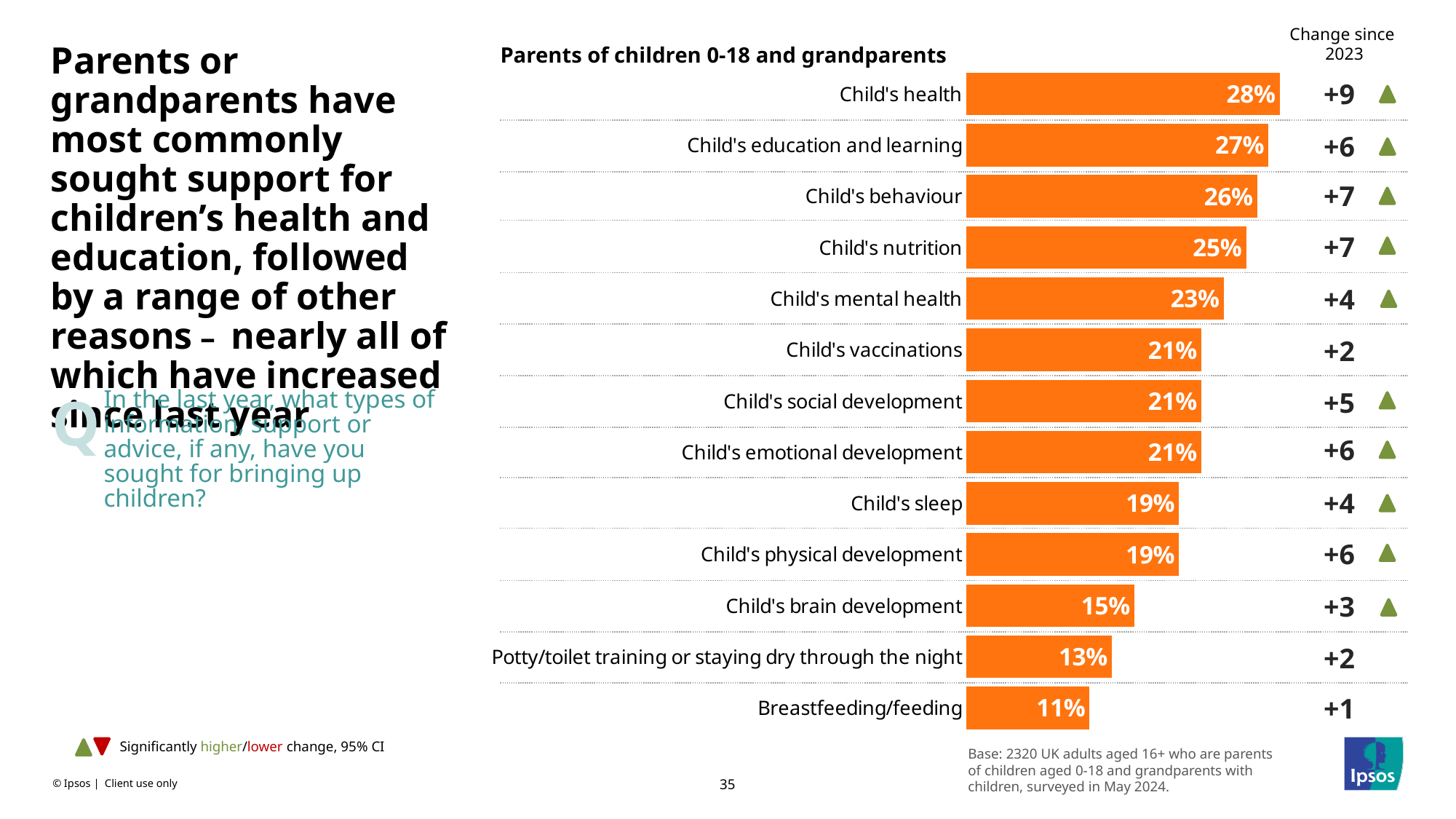
What is the change since 2023 shown for Potty/toilet training or staying dry through the night? +2 What is the value shown for Breastfeeding/feeding? 11% What is the value shown for Child's mental health? 23% Which is larger, the value for Child's nutrition or the value for Child's sleep? Child's nutrition What is the difference between the values for Child's health and Child's brain development? 13 percentage points How many categories are shown in the chart? 13 Which category has the lowest value in the chart? Breastfeeding/feeding What is the title of the chart? Parents of children 0-18 and grandparents What is the change since 2023 shown for Child's health? +9 What percentage of parents and grandparents sought support for Child's health? 28% What kind of chart is shown on the slide? Bar chart Which category has the highest value in the chart? Child's health